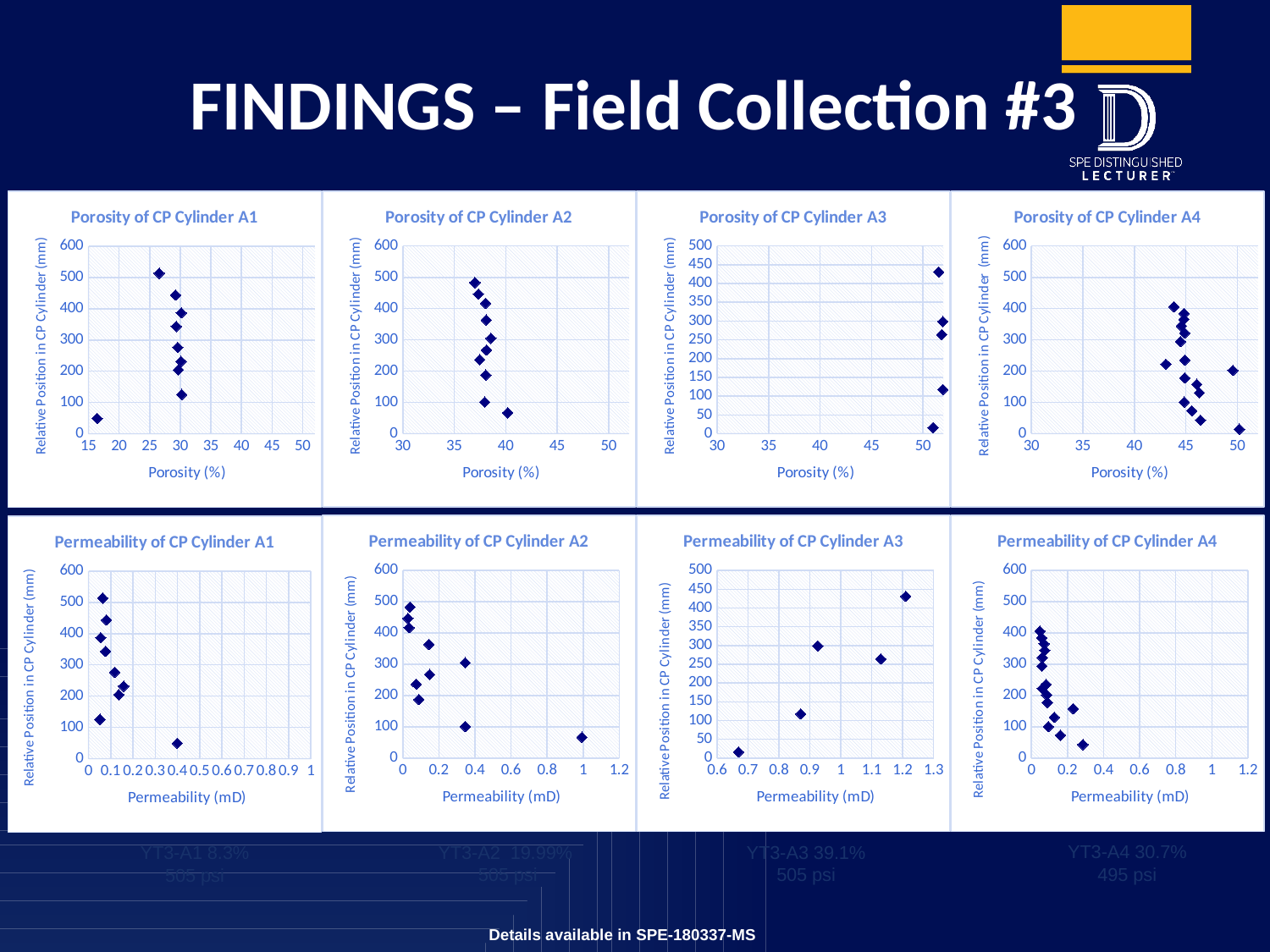
In the 'Permeability of CP Cylinder A3' chart, does relative position generally rise or fall as permeability increases? rise How many data points are plotted in the 'Porosity of CP Cylinder A3' chart? 5 In the 'Permeability of CP Cylinder A1' chart, is the permeability of the point with the highest permeability greater or less than 0.3? greater How many charts are shown on the slide? 8 What kind of chart is 'Porosity of CP Cylinder A1'? scatter chart In the 'Porosity of CP Cylinder A1' chart, is the porosity of the point with the lowest relative position greater or less than 20? less In the 'Permeability of CP Cylinder A3' chart, are all the plotted permeability values greater or less than 0.6? greater In the 'Permeability of CP Cylinder A4' chart, does relative position generally rise or fall as permeability increases? fall How many data points are plotted in the 'Permeability of CP Cylinder A3' chart? 5 What is the y-axis title of the 'Porosity of CP Cylinder A2' chart? Relative Position in CP Cylinder (mm) What is the x-axis title of the 'Permeability of CP Cylinder A2' chart? Permeability (mD)